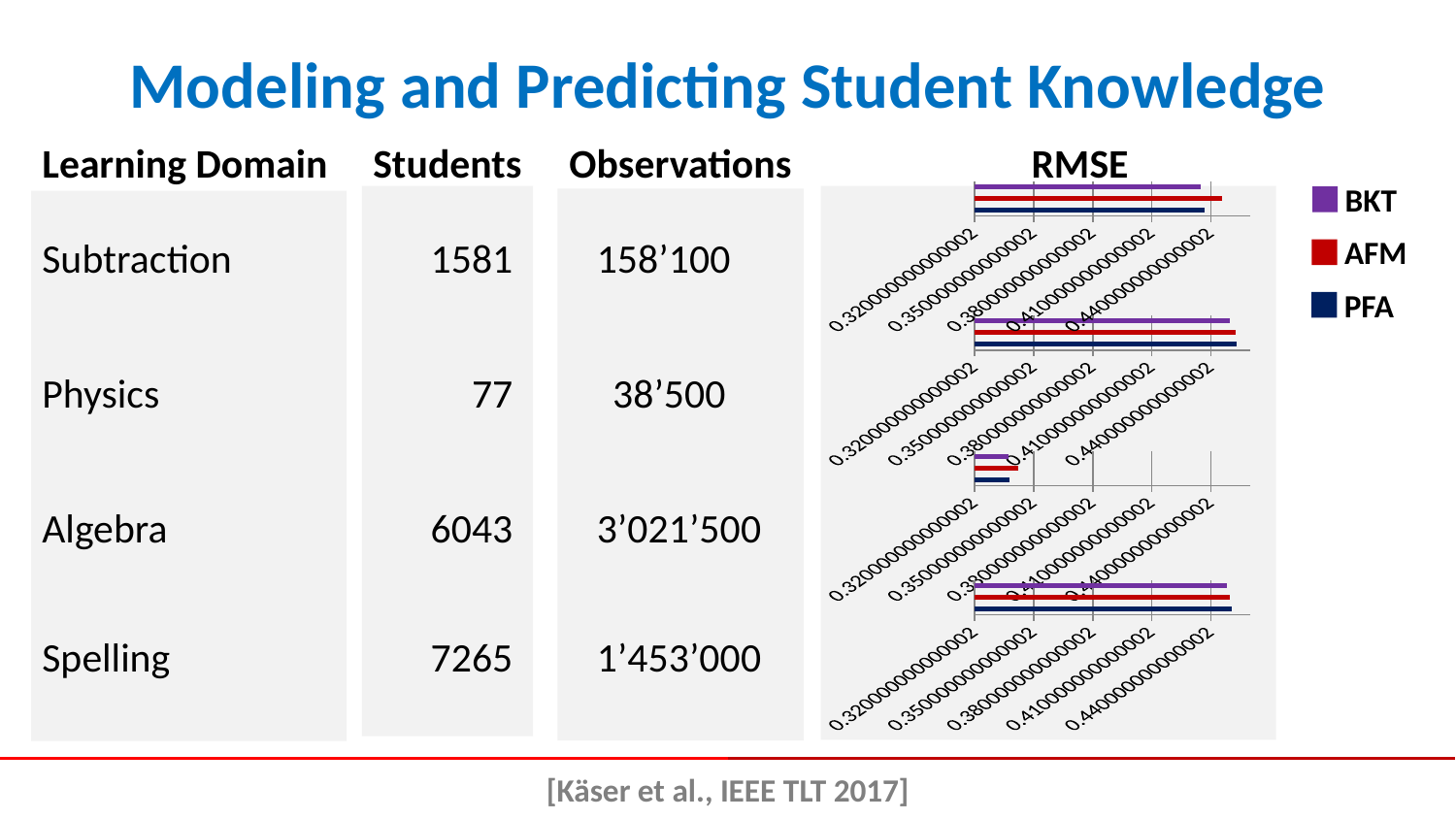
In the RMSE chart for the Algebra row, is the value for BKT greater or less than 0.38? less What kind of chart is used to show the RMSE values on the slide? bar chart In the RMSE chart for the Spelling row, is the value for AFM greater or less than 0.41? greater Which learning domain's RMSE chart shows the shortest bars for all three series? Algebra In the RMSE chart for the Subtraction row, which is larger, the value for AFM or the value for PFA? AFM How many series does the RMSE legend list? 3 Which series are listed in the RMSE legend? BKT, AFM, PFA In the RMSE chart for the Physics row, is the value for PFA greater or less than 0.41? greater In the RMSE legend, which colour represents BKT? purple How many bars are plotted in the RMSE chart for the Subtraction row? 3